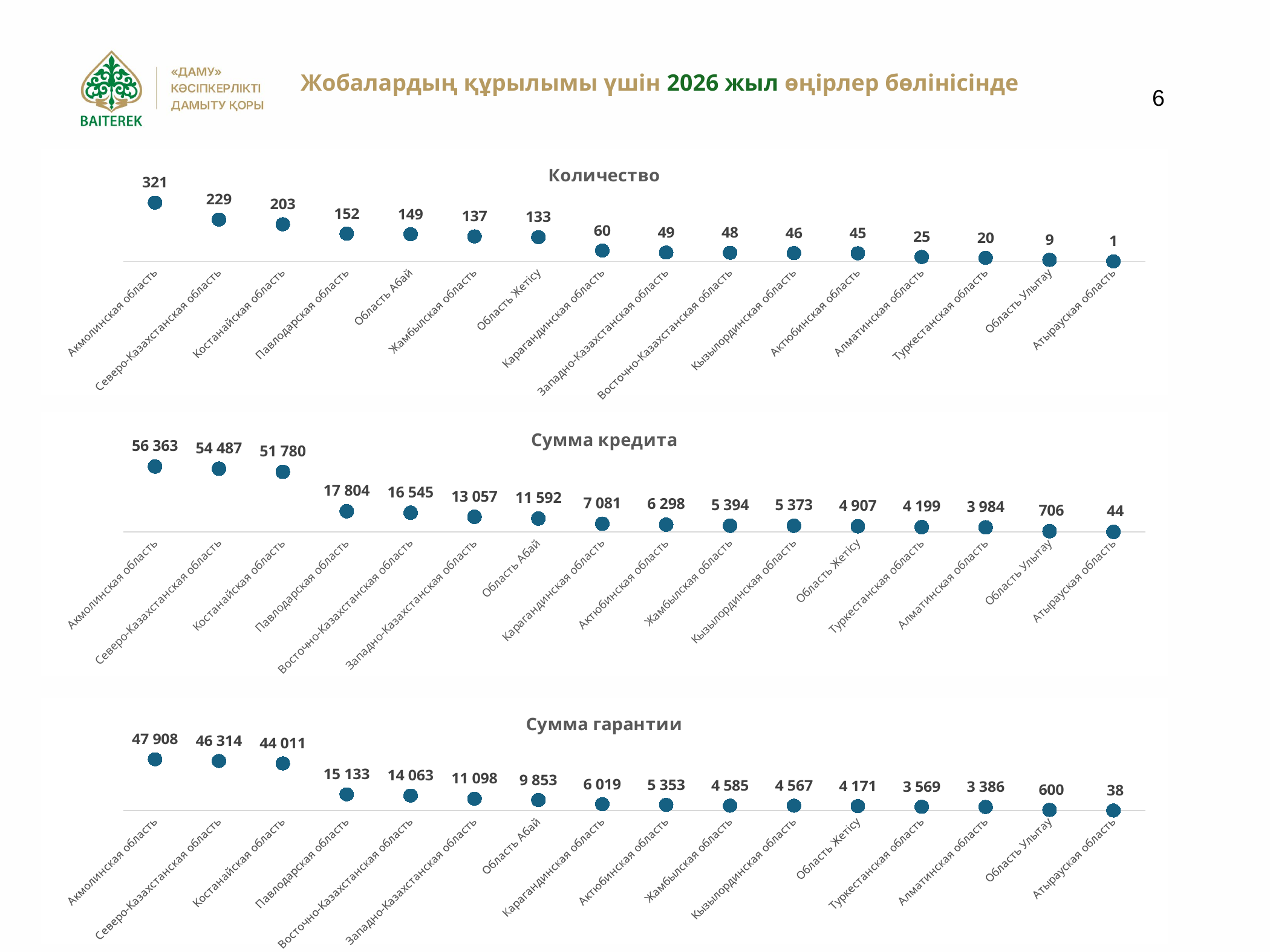
In the "Сумма гарантии" chart, what is the value for Восточно-Казахстанская область? 14 063 In the "Количество" chart, which region has the lowest value? Атырауская область In the "Сумма гарантии" chart, what is the difference between Акмолинская область and Северо-Казахстанская область? 1 594 In the "Сумма кредита" chart, which region has the highest value? Акмолинская область In the "Сумма кредита" chart, what is the value for Павлодарская область? 17 804 In the "Сумма кредита" chart, what is the value for Область Улытау? 706 In the "Количество" chart, how many regions are plotted? 16 What is the title of the bottom chart on the slide? Сумма гарантии In the "Количество" chart, what is the value for Акмолинская область? 321 In the "Сумма гарантии" chart, do the values rise or fall from left to right? fall In the "Сумма кредита" chart, which is larger: Область Абай or Карагандинская область? Область Абай In the "Количество" chart, what is the difference between Северо-Казахстанская область and Костанайская область? 26